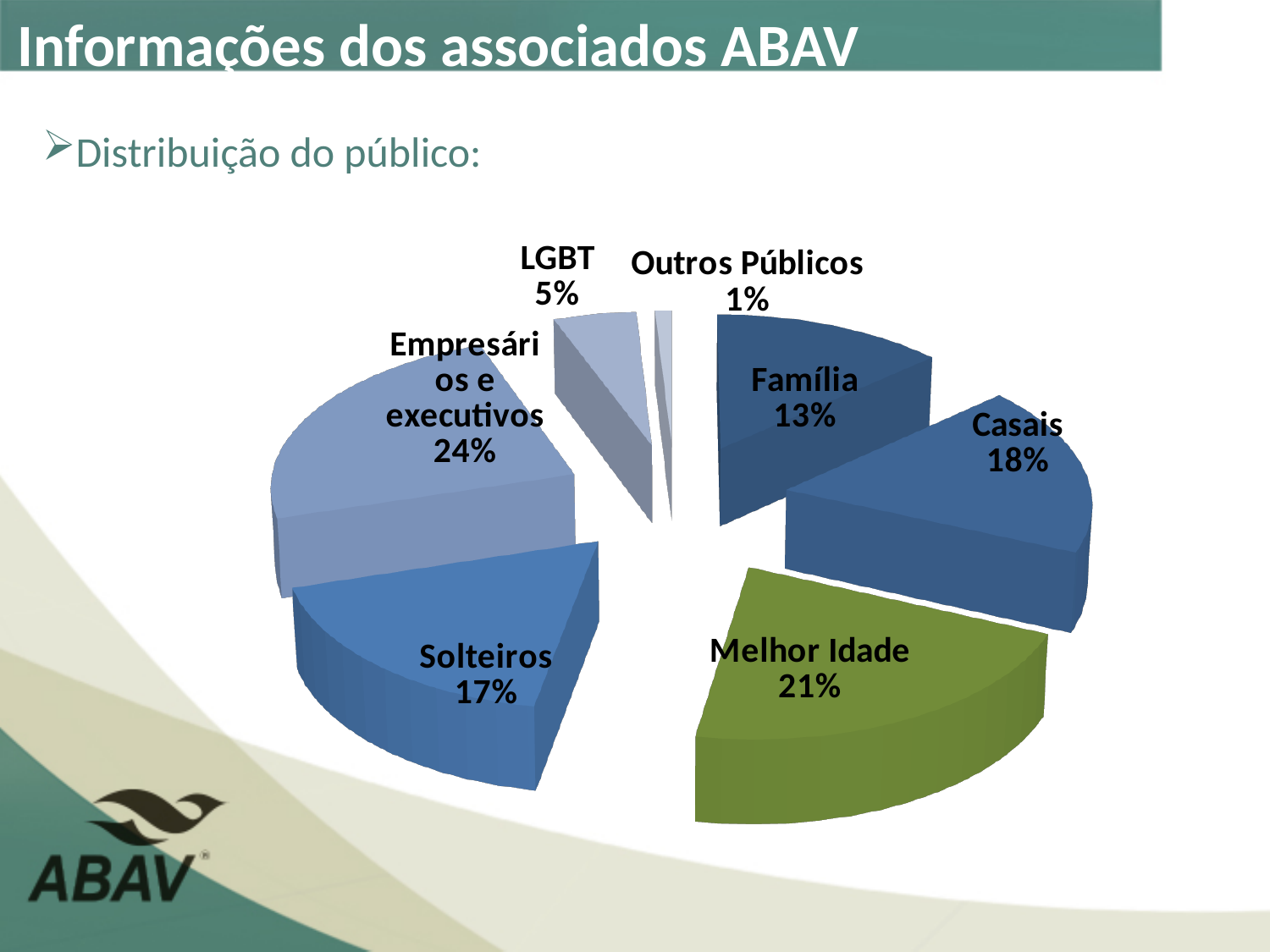
What share of the public is LGBT? 5% What share of the public is Casais? 18% What share of the public is Família? 13% What kind of chart is shown on the slide? Pie chart What share of the public is Melhor Idade? 21% Which category has the smallest share of the public? Outros Públicos Which has a larger share, Casais or Solteiros? Casais What share of the public is Solteiros? 17% How many categories are shown in the pie chart? 7 Which category has the largest share of the public? Empresários e executivos What is the difference in percentage points between Melhor Idade and Família? 8 What share of the public is Empresários e executivos? 24%